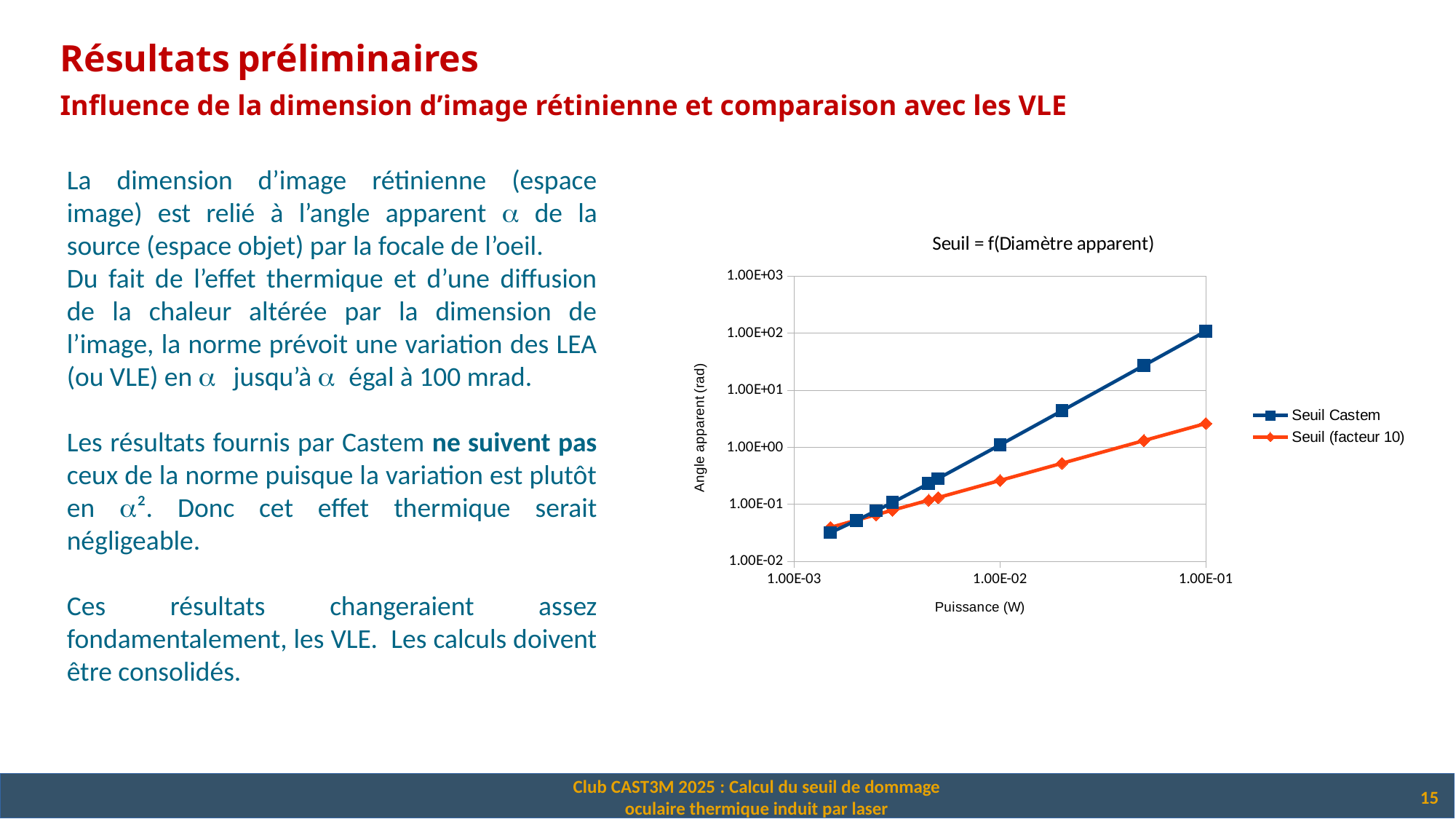
Is the value of Seuil (facteur 10) at Puissance 1.00E-02 W greater or less than 1.00E+00 rad? less Is the value of Seuil Castem at Puissance 1.00E-02 W greater or less than 1.00E-01 rad? greater Which series reaches the highest Angle apparent value on the chart? Seuil Castem What kind of chart is shown on the slide? line chart At Puissance 1.00E-01 W, which series has the larger Angle apparent value, Seuil Castem or Seuil (facteur 10)? Seuil Castem What is the title of the chart? Seuil = f(Diamètre apparent) Do the values of the Seuil (facteur 10) series rise or fall as Puissance (W) increases? rise How many series does the legend of the chart list? 2 Is the value of Seuil Castem at Puissance 1.00E-01 W greater or less than 1.00E+01 rad? greater What is the label of the x axis of the chart? Puissance (W) Do the values of the Seuil Castem series rise or fall as Puissance (W) increases? rise